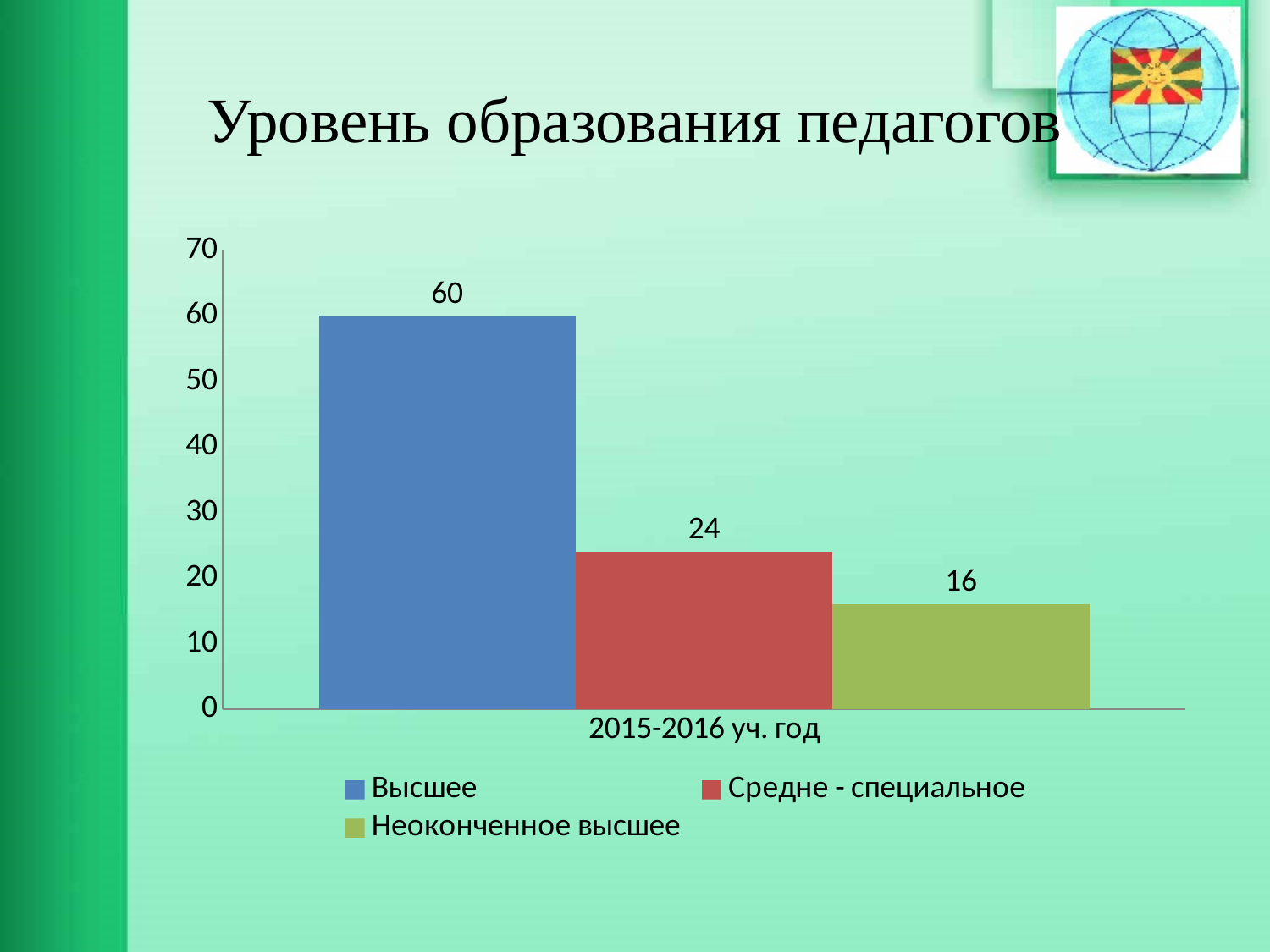
What is the value for Высшее in the chart? 60 What is the title of the slide's chart? Уровень образования педагогов What is the value for Неоконченное высшее in the chart? 16 What is the value for Средне - специальное in the chart? 24 How many series does the legend list? 3 Which series has the highest value in the chart? Высшее What is the difference between the values for Высшее and Средне - специальное? 36 What is the difference between the values for Средне - специальное and Неоконченное высшее? 8 Which series has the lowest value in the chart? Неоконченное высшее Which is larger, the value for Средне - специальное or the value for Неоконченное высшее? Средне - специальное What category label is shown on the x axis of the chart? 2015-2016 уч. год What kind of chart is shown on the slide? Bar chart